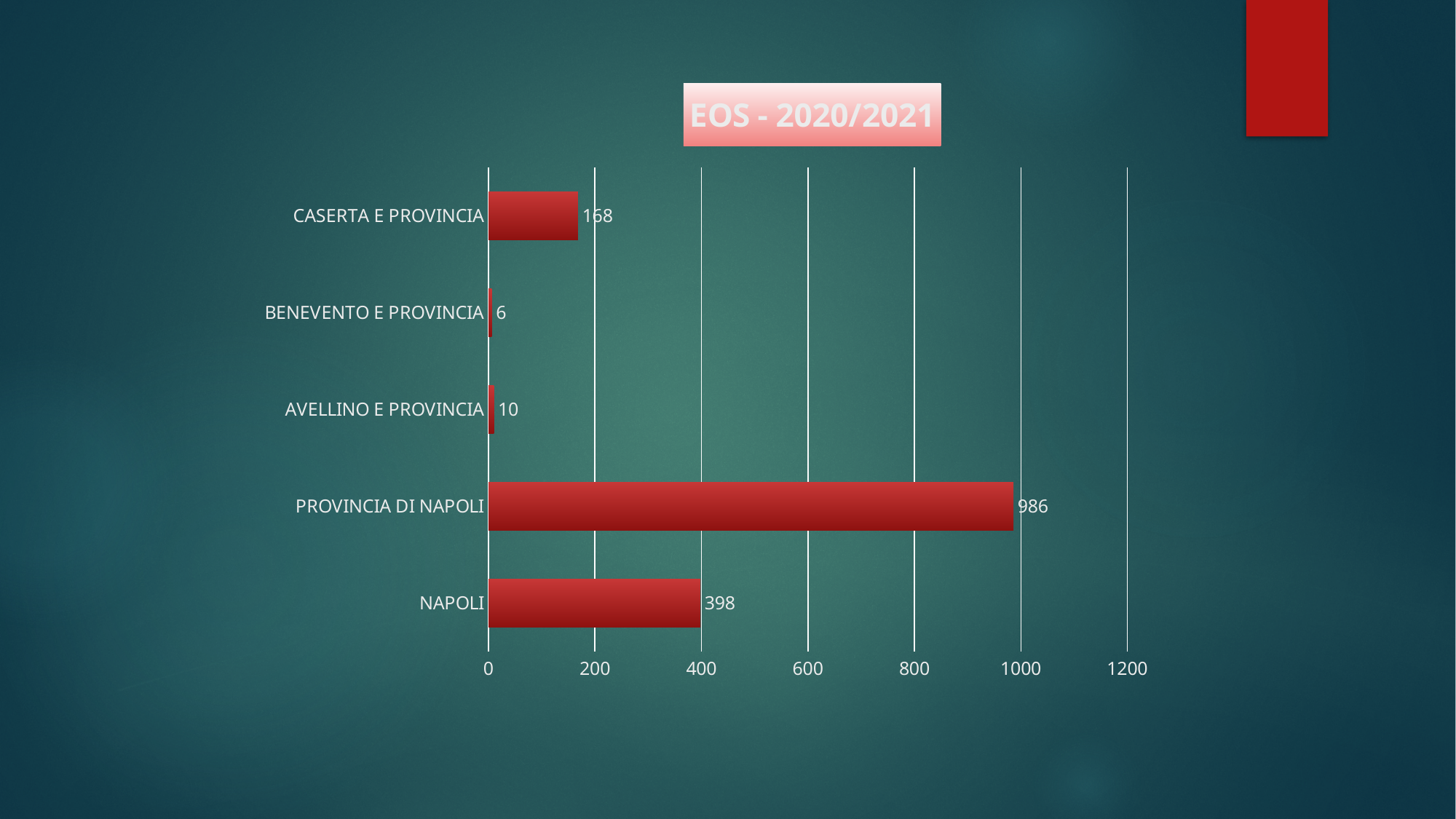
What is the value for CASERTA E PROVINCIA? 168 What kind of chart is shown on the slide? bar chart What is the title of the chart? EOS - 2020/2021 Which category has the highest value? PROVINCIA DI NAPOLI What is the value for NAPOLI? 398 What is the value for BENEVENTO E PROVINCIA? 6 How many categories are shown in the chart? 5 What is the value for PROVINCIA DI NAPOLI? 986 Is the value for NAPOLI greater or less than 200? greater What is the difference between the values for PROVINCIA DI NAPOLI and NAPOLI? 588 Which is larger, the value for CASERTA E PROVINCIA or the value for AVELLINO E PROVINCIA? CASERTA E PROVINCIA Which category has the lowest value? BENEVENTO E PROVINCIA